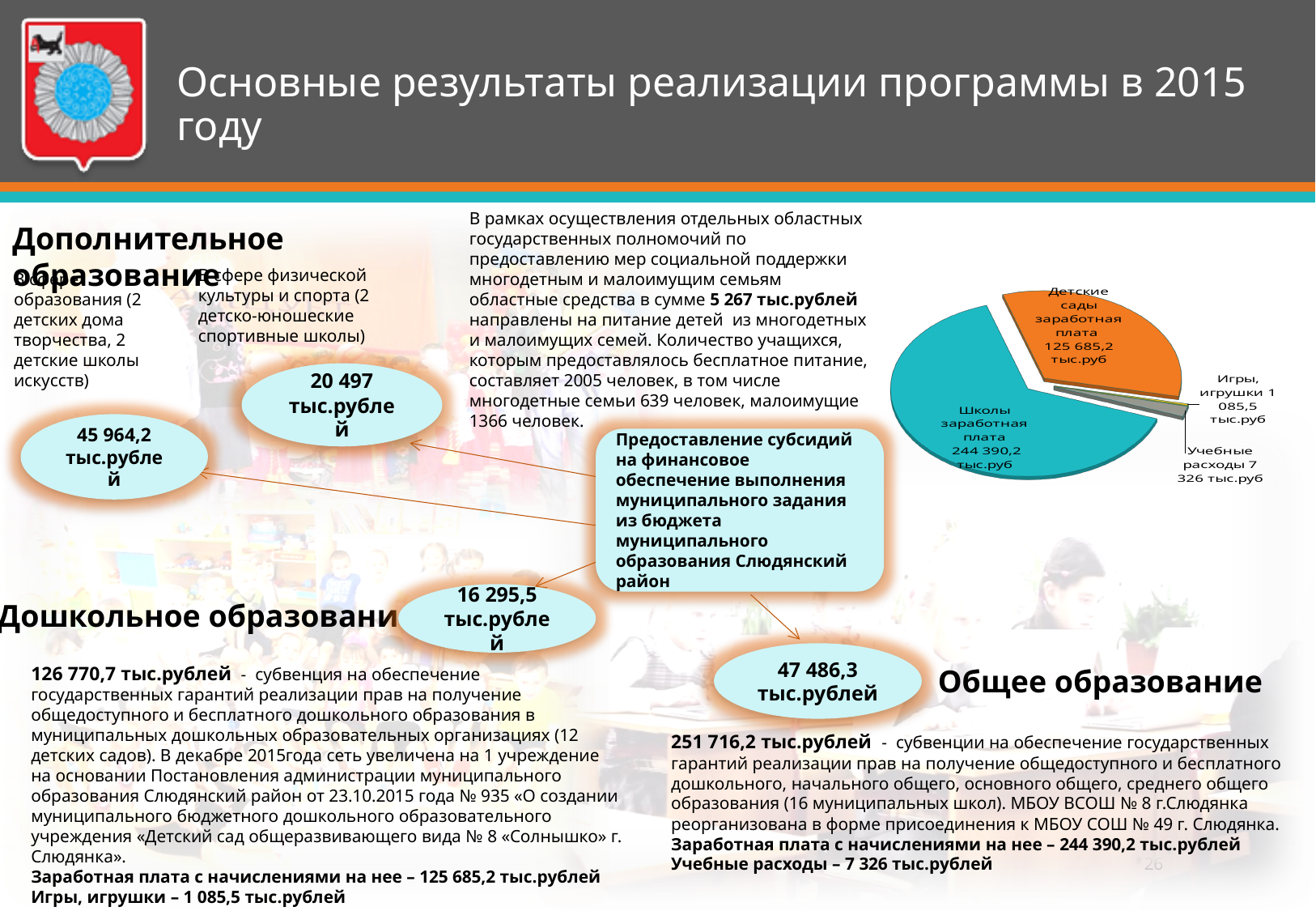
What is the difference between the "Школы заработная плата" and "Детские сады заработная плата" values in the pie chart? 118 705 тыс.руб What value is shown for the slice "Учебные расходы" in the pie chart? 7 326 тыс.руб What kind of chart is shown on the slide? pie chart Which is larger in the pie chart: "Школы заработная плата" or "Детские сады заработная плата"? Школы заработная плата What value is shown for the slice "Детские сады заработная плата" in the pie chart? 125 685,2 тыс.руб Which slice of the pie chart is the largest? Школы заработная плата Which slice of the pie chart is the smallest? Игры, игрушки What colour is the "Детские сады заработная плата" slice in the pie chart? orange What value is shown for the slice "Школы заработная плата" in the pie chart? 244 390,2 тыс.руб How many slices does the pie chart have? 4 What value is shown for the slice "Игры, игрушки" in the pie chart? 1 085,5 тыс.руб Which is larger in the pie chart: "Учебные расходы" or "Игры, игрушки"? Учебные расходы